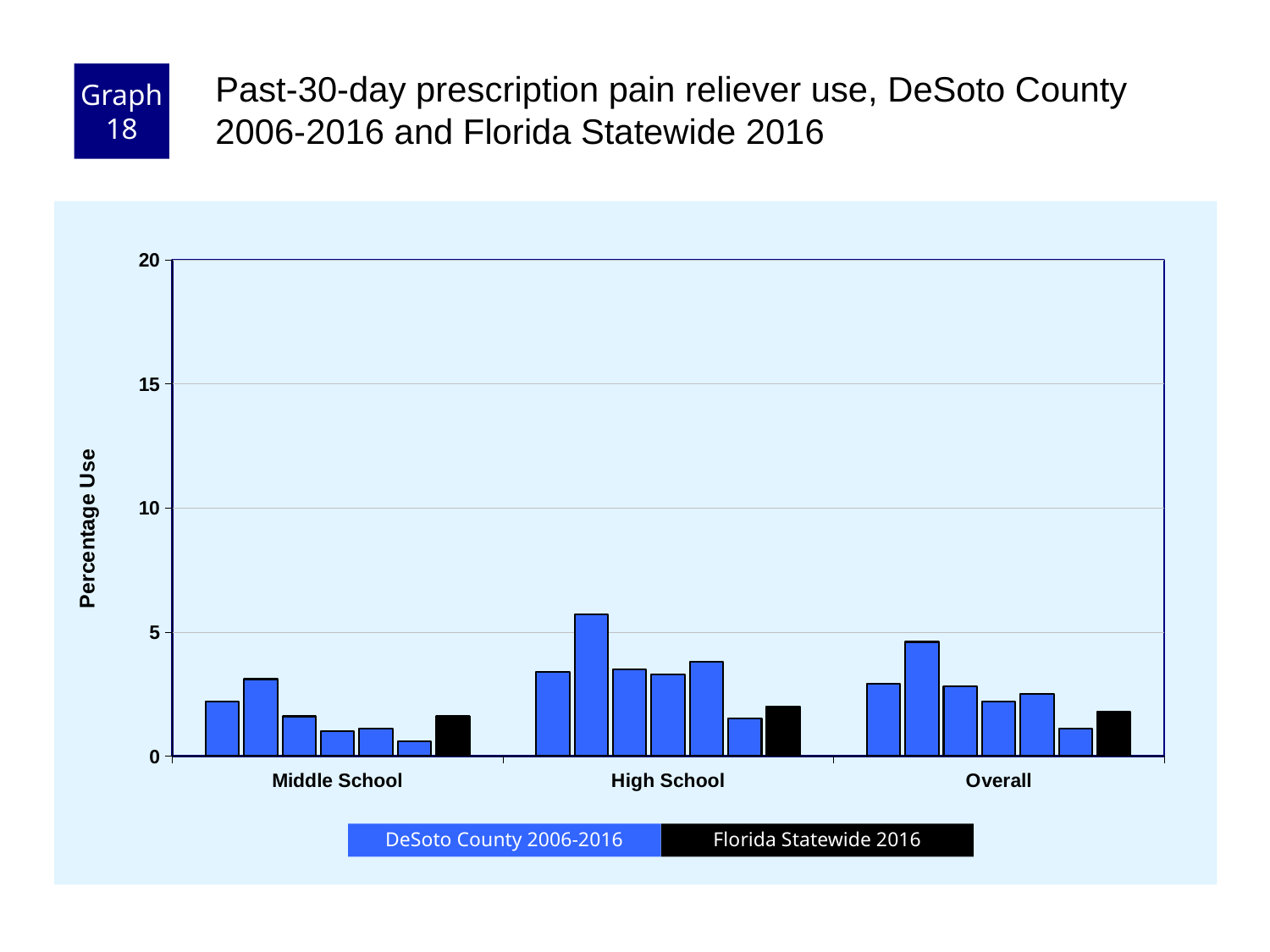
Are any bars on the chart greater than 10? No How many categories are shown along the x axis? 3 Is the tallest bar in the Middle School group greater or less than 5? less Which category group contains the tallest bar on the chart? High School What is the label of the y axis? Percentage Use Is the tallest bar in the Overall group greater or less than 5? less Which is larger: the Florida Statewide 2016 value for High School or for Middle School? High School What kind of chart is shown on the slide? Bar chart Which colour represents Florida Statewide 2016 in the legend? Black How many series does the legend list? 2